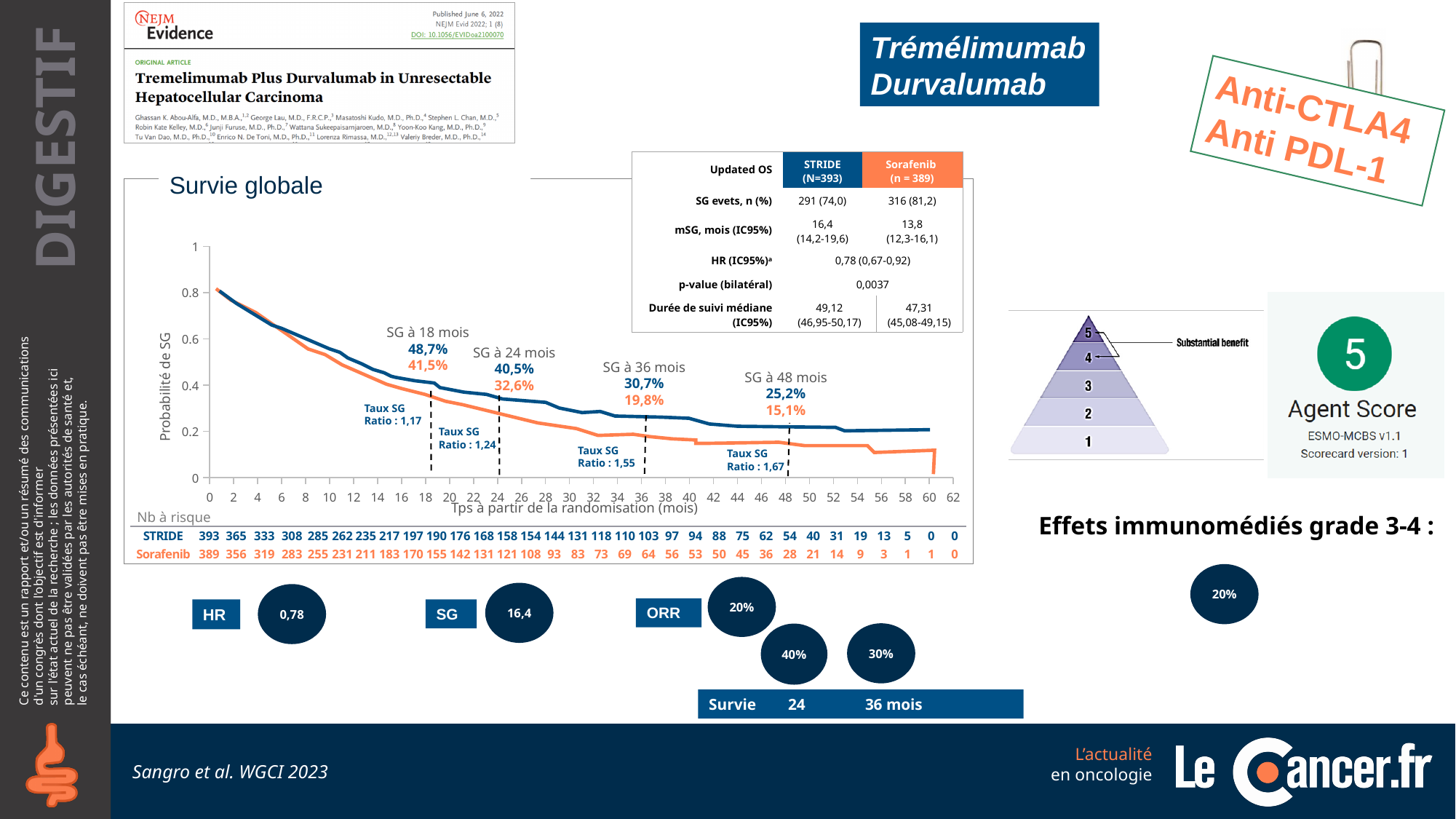
What is the label of the y axis on the 'Survie globale' chart? Probabilité de SG On the 'Survie globale' chart, what is the difference in percentage points between STRIDE and Sorafenib survival at 18 months? 7,2 points In the 'Nb à risque' row below the 'Survie globale' chart, how many STRIDE patients are at risk at time 0? 393 On the 'Survie globale' chart, what is the 'Taux SG Ratio' shown at 36 months? 1,55 On the 'Survie globale' chart, do the survival curves rise or fall as time from randomisation increases? Fall What kind of chart is the 'Survie globale' chart? Line chart (Kaplan-Meier survival curve) On the 'Survie globale' chart, what is the difference in percentage points between STRIDE and Sorafenib survival at 36 months? 10,9 points On the 'Survie globale' chart, what is the survival probability for STRIDE at 48 months (SG à 48 mois)? 25,2% On the 'Survie globale' chart, what is the survival probability for STRIDE at 18 months (SG à 18 mois)? 48,7% On the 'Survie globale' chart, what is the survival probability for Sorafenib at 24 months (SG à 24 mois)? 32,6% On the 'Survie globale' chart, which arm has the higher survival probability at 48 months, STRIDE or Sorafenib? STRIDE On the 'Survie globale' chart, how many treatment arms (curves) are plotted? 2